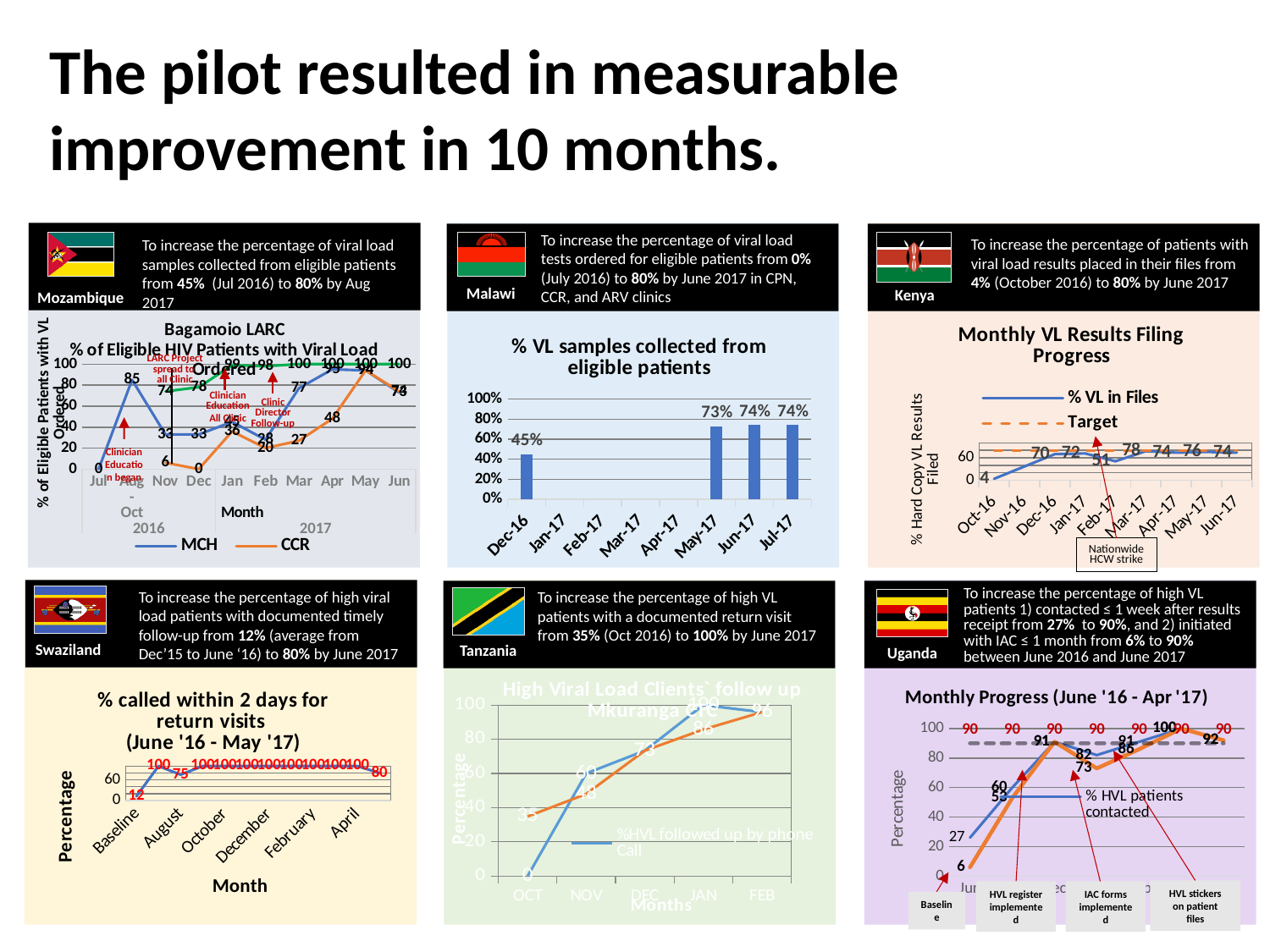
In the Uganda chart 'Monthly Progress (June '16 - Apr '17)', what is the value of the dashed target line? 90 In the Malawi chart '% VL samples collected from eligible patients', what kind of chart is shown? bar chart In the Kenya chart 'Monthly VL Results Filing Progress', what is the % VL in Files value for Oct-16? 4 In the Kenya chart 'Monthly VL Results Filing Progress', which month has the highest % VL in Files value? Mar-17 In the Malawi chart '% VL samples collected from eligible patients', by how many percentage points does Jul-17 exceed Dec-16? 29 percentage points In the Malawi chart '% VL samples collected from eligible patients', what is the value for Jul-17? 74% In the Kenya chart 'Monthly VL Results Filing Progress', what is the % VL in Files value for Feb-17? 51 In the Malawi chart '% VL samples collected from eligible patients', what is the value for May-17? 73% In the Swaziland chart '% called within 2 days for return visits', what is the value at Baseline? 12 In the Kenya chart 'Monthly VL Results Filing Progress', how many series does the legend list? 2 In the Malawi chart '% VL samples collected from eligible patients', what is the value for Dec-16? 45% In the Kenya chart 'Monthly VL Results Filing Progress', which month has the lowest % VL in Files value? Oct-16